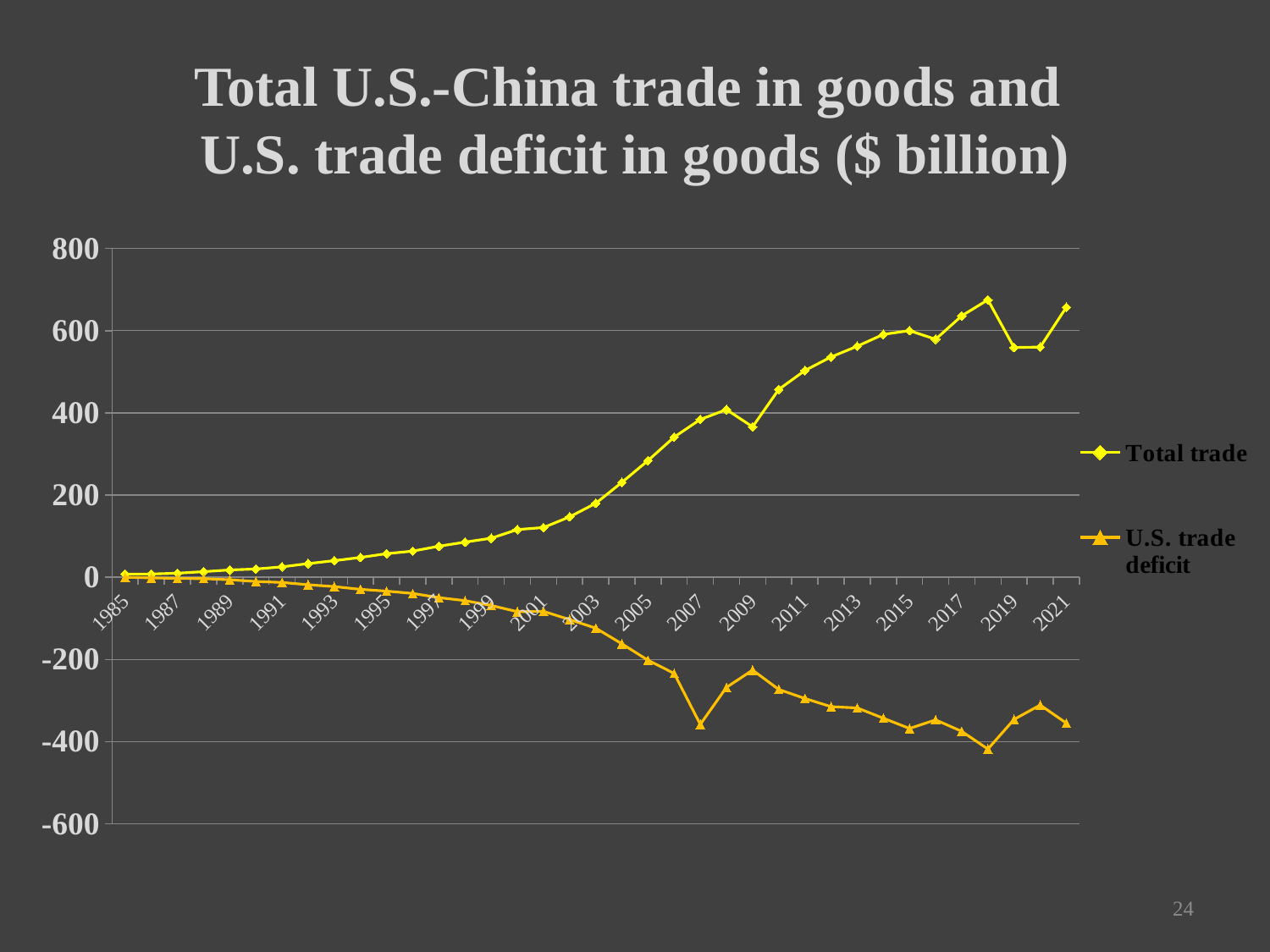
What are the two series named in the legend? Total trade and U.S. trade deficit Is the U.S. trade deficit value for 2007 greater or less than -200? less What kind of chart is shown on the slide? line chart In which year does the Total trade series reach its highest value? 2018 Is the Total trade value for 2009 greater or less than 400? less Does the Total trade series generally rise or fall from 1985 to 2021? rise Which year has the higher Total trade value, 2018 or 2019? 2018 What is the title of the chart? Total U.S.-China trade in goods and U.S. trade deficit in goods ($ billion) In which year does the U.S. trade deficit series reach its lowest (most negative) value? 2018 Is the Total trade value for 2021 greater or less than 600? greater How many series does the legend list? 2 How many year labels are shown on the x axis? 19